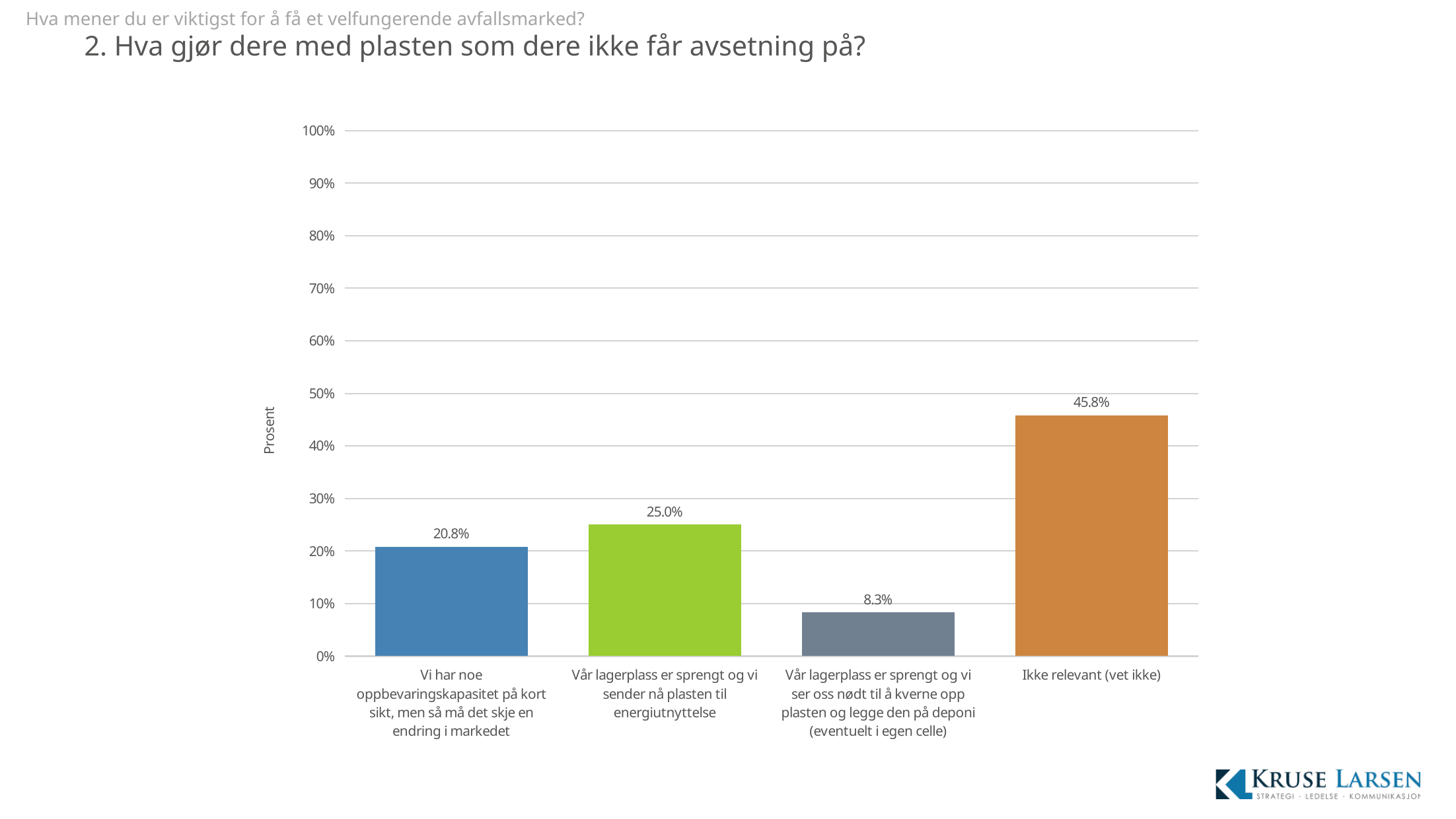
How many categories are shown in the chart? 4 Which category has the lowest value? Vår lagerplass er sprengt og vi ser oss nødt til å kverne opp plasten og legge den på deponi (eventuelt i egen celle) What is the value for "Vår lagerplass er sprengt og vi sender nå plasten til energiutnyttelse"? 25.0% What colour is the bar for "Ikke relevant (vet ikke)"? orange What kind of chart is shown on the slide? bar chart What is the value for "Ikke relevant (vet ikke)"? 45.8% What is the label of the vertical axis? Prosent What is the difference between the value for "Ikke relevant (vet ikke)" and the value for "Vår lagerplass er sprengt og vi sender nå plasten til energiutnyttelse"? 20.8% Which is larger: the value for "Vi har noe oppbevaringskapasitet på kort sikt, men så må det skje en endring i markedet" or the value for "Vår lagerplass er sprengt og vi sender nå plasten til energiutnyttelse"? Vår lagerplass er sprengt og vi sender nå plasten til energiutnyttelse Which category has the highest value? Ikke relevant (vet ikke) What is the value for "Vi har noe oppbevaringskapasitet på kort sikt, men så må det skje en endring i markedet"? 20.8% Is the value for "Ikke relevant (vet ikke)" greater or less than 40%? greater